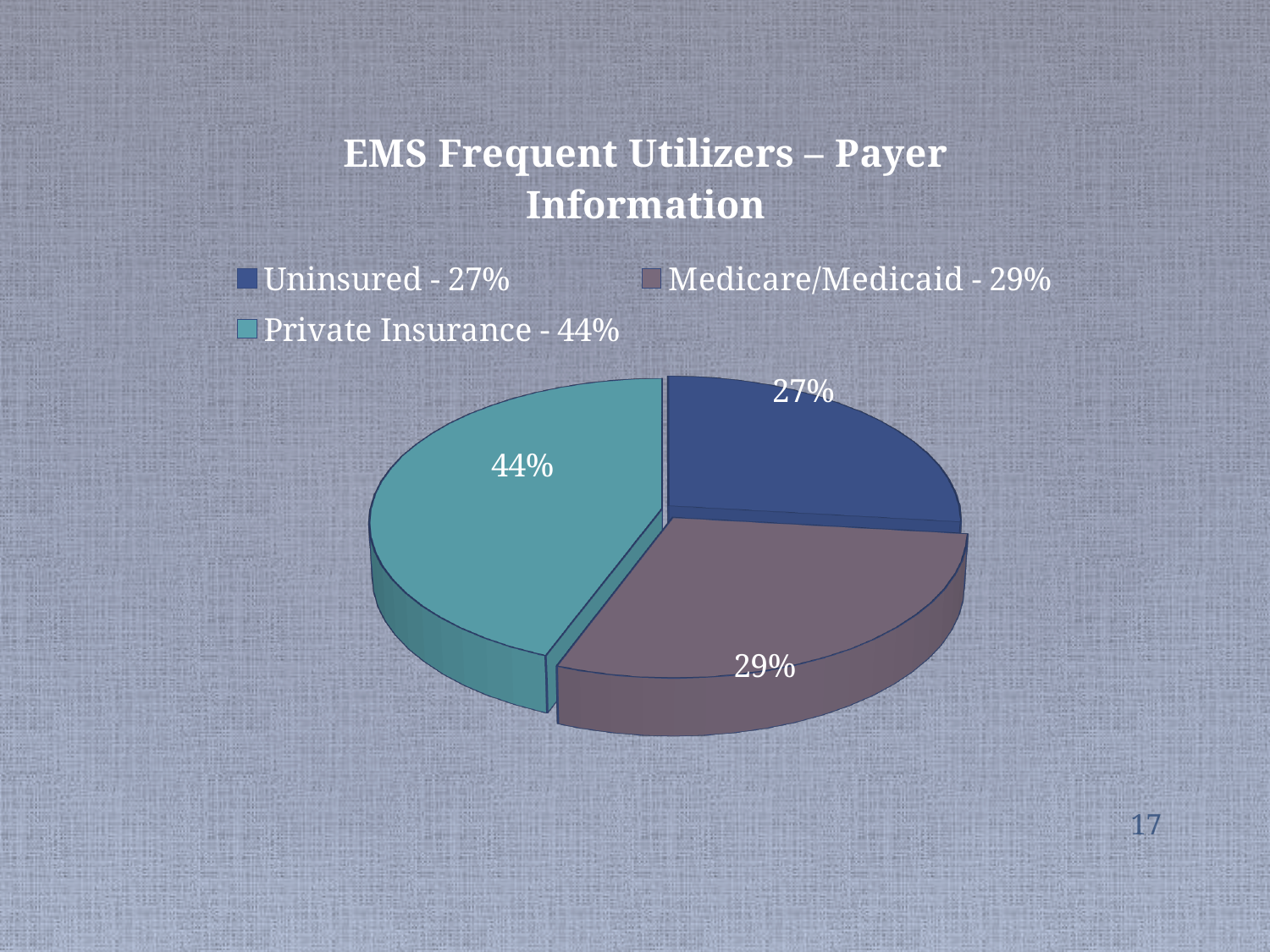
How many slices does the pie chart have? 3 What is the difference between the Medicare/Medicaid share and the Uninsured share? 2% What share of the pie is Private Insurance? 44% Which payer category has the smallest share? Uninsured Which is larger, the Medicare/Medicaid share or the Uninsured share? Medicare/Medicaid What kind of chart is shown on the slide? Pie chart What share of the pie is Uninsured? 27% What is the chart's title? EMS Frequent Utilizers – Payer Information How many entries does the legend list? 3 Which payer category has the largest share? Private Insurance What is the difference between the Private Insurance share and the Uninsured share? 17% What share of the pie is Medicare/Medicaid? 29%